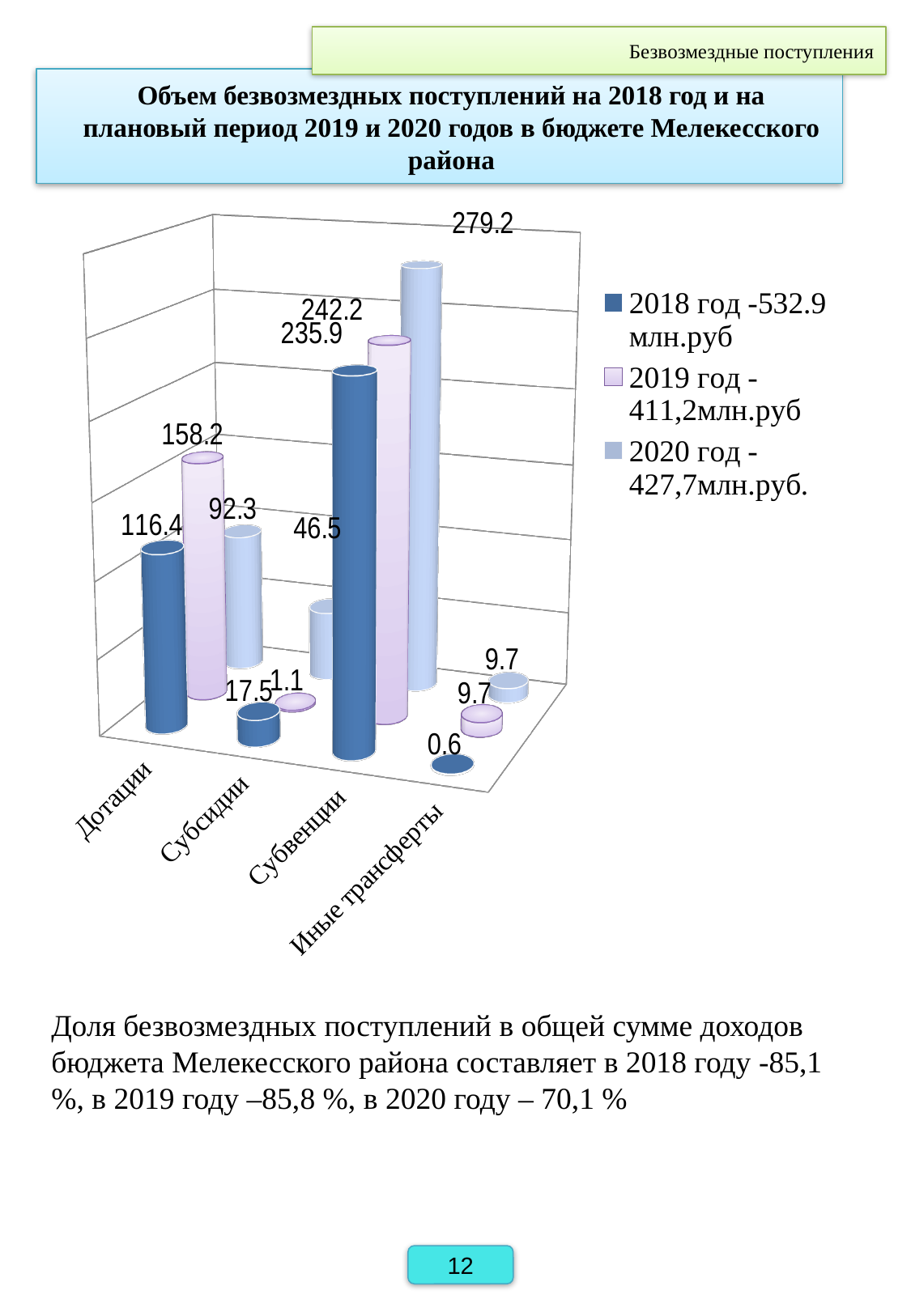
How many series does the legend list? 3 What is the value for Субсидии in the 2019 series? 1.1 What is the value for Иные трансферты in the 2018 series? 0.6 How many categories are shown on the x axis? 4 Which category has the lowest value in the 2020 series? Иные трансферты According to the legend, what is the total for 2020 год? 427,7млн.руб. Which category has the highest value in the 2019 series? Субвенции What is the difference between the 2019 and 2018 values for Дотации? 41.8 What kind of chart is shown on the slide? bar chart What is the value for Дотации in the 2018 series? 116.4 What is the value for Субвенции in the 2020 series? 279.2 Which is larger for Субвенции: the 2018 value or the 2019 value? 2019